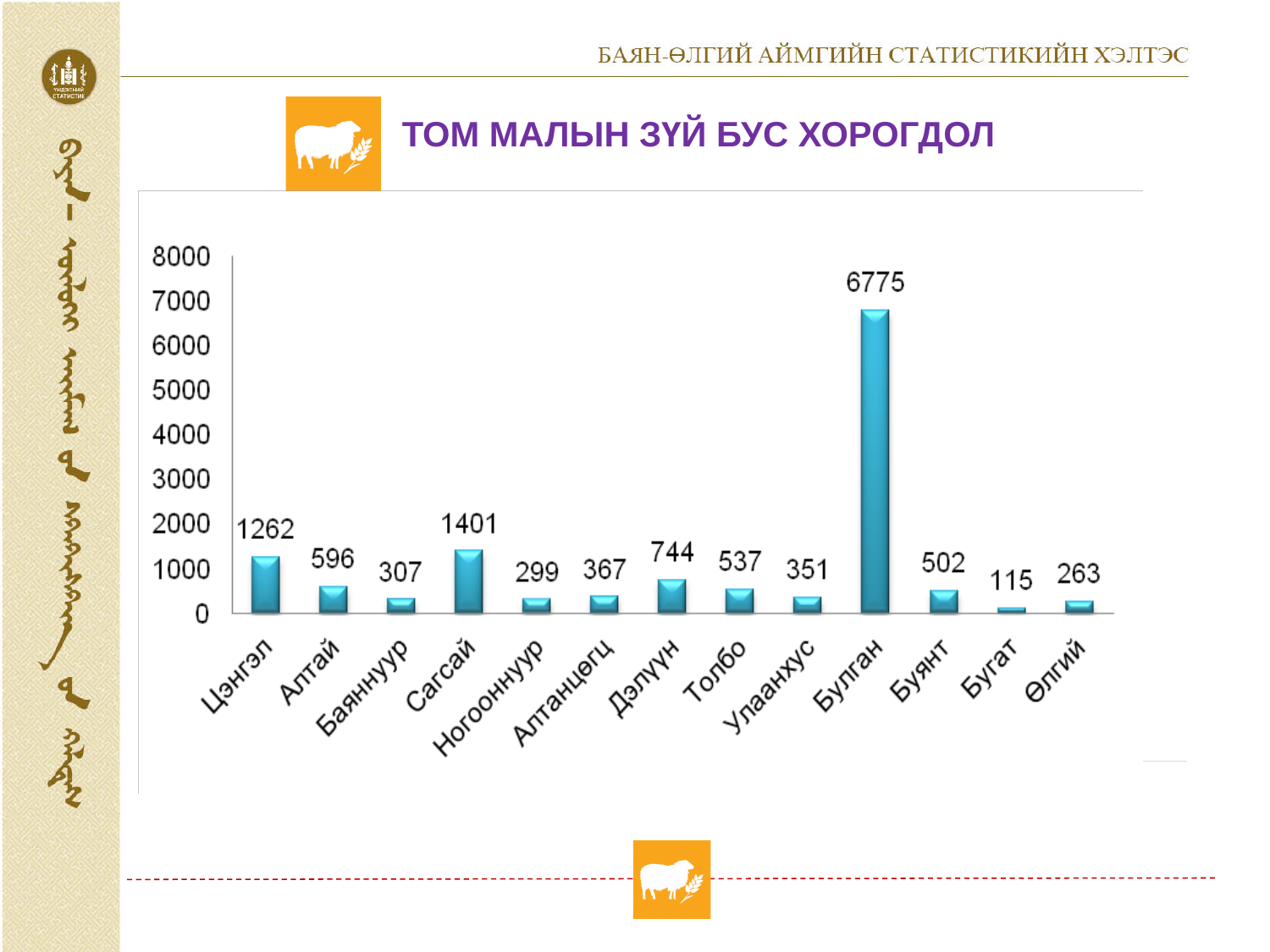
Which category has the lowest value? Бугат Is the value for Булган greater or less than 6000? greater What is the value for Сагсай? 1401 What is the difference between the values for Сагсай and Цэнгэл? 139 Which category has the highest value? Булган What kind of chart is shown on the slide? bar chart How many categories are shown on the x axis? 13 What is the title of the slide above the chart? ТОМ МАЛЫН ЗҮЙ БУС ХОРОГДОЛ What is the difference between the values for Булган and Дэлүүн? 6031 What is the value for Бугат? 115 What is the value for Булган? 6775 Which is larger, the value for Алтай or the value for Толбо? Алтай